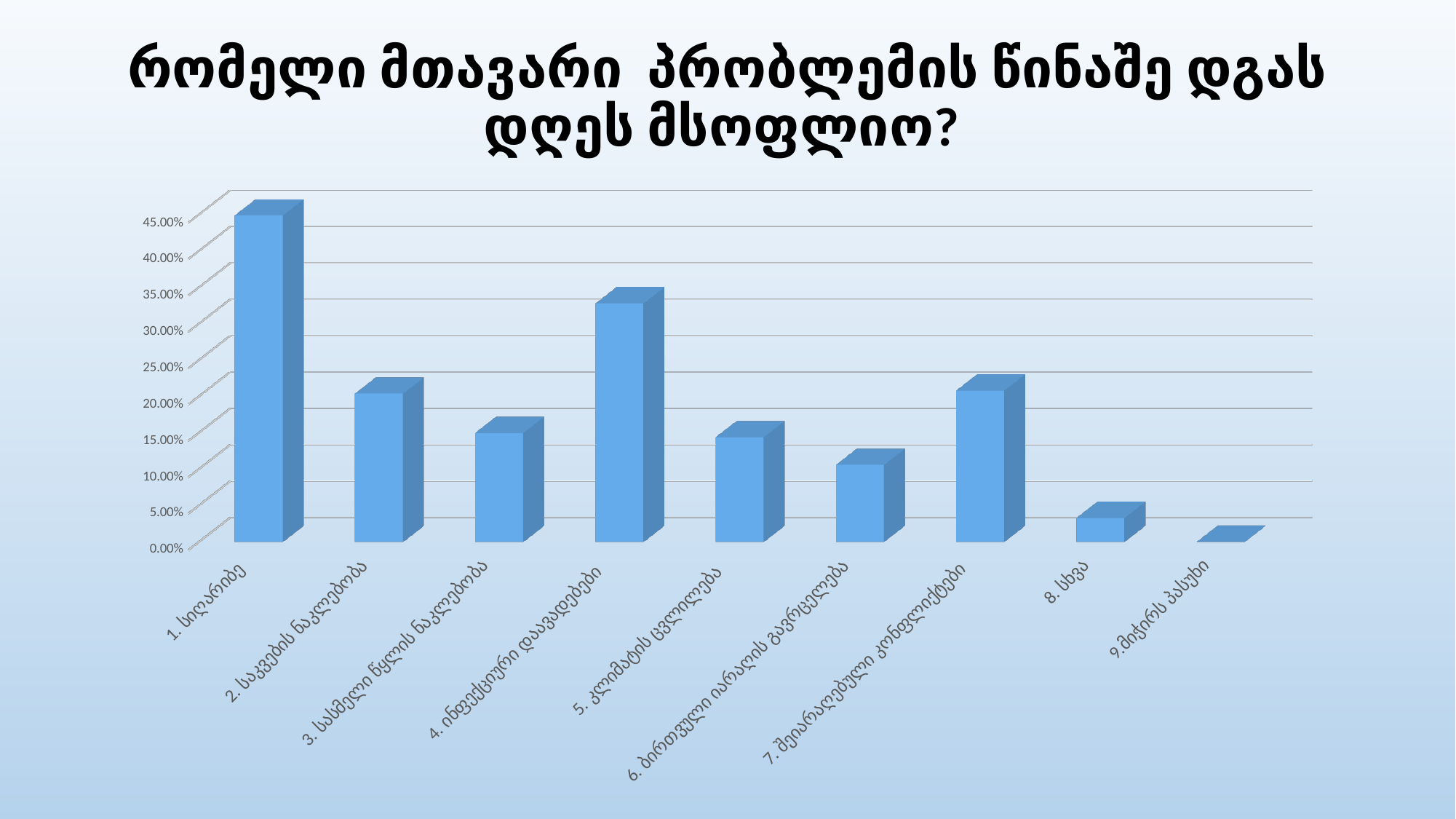
Is the value for 6. ბირთვული იარაღის გავრცელება greater or less than 15.00%? less How many categories are plotted on the chart? 9 Which is larger, the value for 1. სიღარიბე or the value for 4. ინფექციური დაავადებები? 1. სიღარიბე Is the value for 8. სხვა greater or less than 5.00%? less Is the value for 1. სიღარიბე greater or less than 40.00%? greater Which category has the lowest value? 9.მიჭირს პასუხი Which is larger, the value for 4. ინფექციური დაავადებები or the value for 2. საკვების ნაკლებობა? 4. ინფექციური დაავადებები What kind of chart is shown on the slide? bar chart What is the title of the chart on the slide? რომელი მთავარი პრობლემის წინაშე დგას დღეს მსოფლიო? Which category has the highest value? 1. სიღარიბე